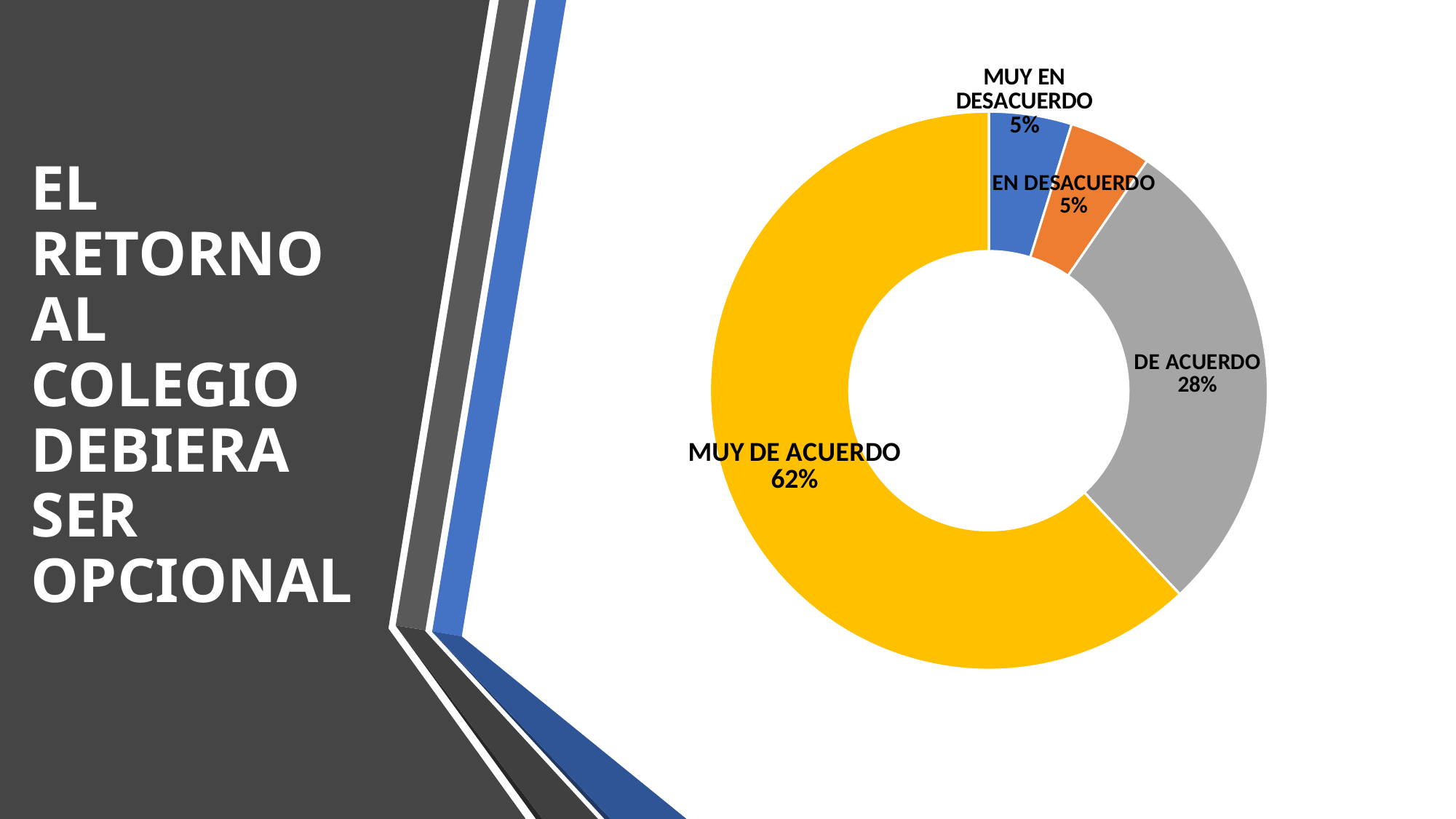
What percentage of respondents answered DE ACUERDO? 28% What kind of chart is shown on the slide? Doughnut chart Which category has the largest share of the chart? MUY DE ACUERDO What is the difference in percentage points between MUY DE ACUERDO and DE ACUERDO? 34 What is the title text on the left of the slide? EL RETORNO AL COLEGIO DEBIERA SER OPCIONAL Which is larger, the share for DE ACUERDO or the share for EN DESACUERDO? DE ACUERDO What colour is the MUY DE ACUERDO segment? Yellow What percentage of respondents answered MUY EN DESACUERDO? 5% How many categories are shown in the chart? 4 What is the combined share of MUY DE ACUERDO and DE ACUERDO? 90% What percentage of respondents answered EN DESACUERDO? 5% What percentage of respondents answered MUY DE ACUERDO? 62%